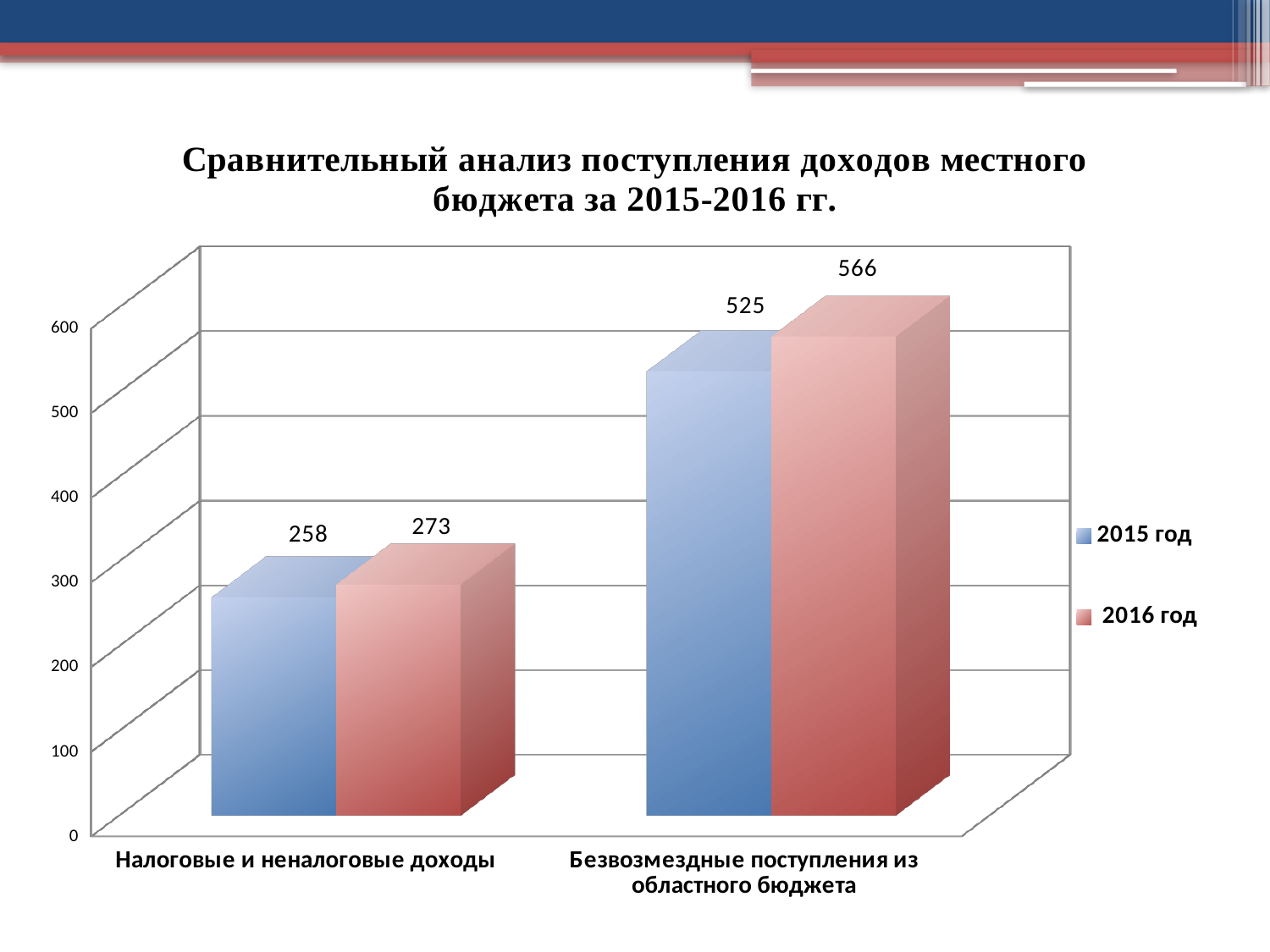
What is the value for 2015 год for Налоговые и неналоговые доходы? 258 How many series does the legend list? 2 Which is larger for Налоговые и неналоговые доходы: the 2015 год value or the 2016 год value? 2016 год What is the difference between the 2016 год and 2015 год values for Безвозмездные поступления из областного бюджета? 41 What is the difference between the 2016 год and 2015 год values for Налоговые и неналоговые доходы? 15 How many categories are shown on the x axis? 2 What kind of chart is shown on the slide? bar chart What is the value for 2016 год for Безвозмездные поступления из областного бюджета? 566 Which category has the lowest value for 2015 год? Налоговые и неналоговые доходы What is the value for 2015 год for Безвозмездные поступления из областного бюджета? 525 Which category has the highest value for 2016 год? Безвозмездные поступления из областного бюджета Is the 2015 год value for Безвозмездные поступления из областного бюджета greater or less than 500? greater